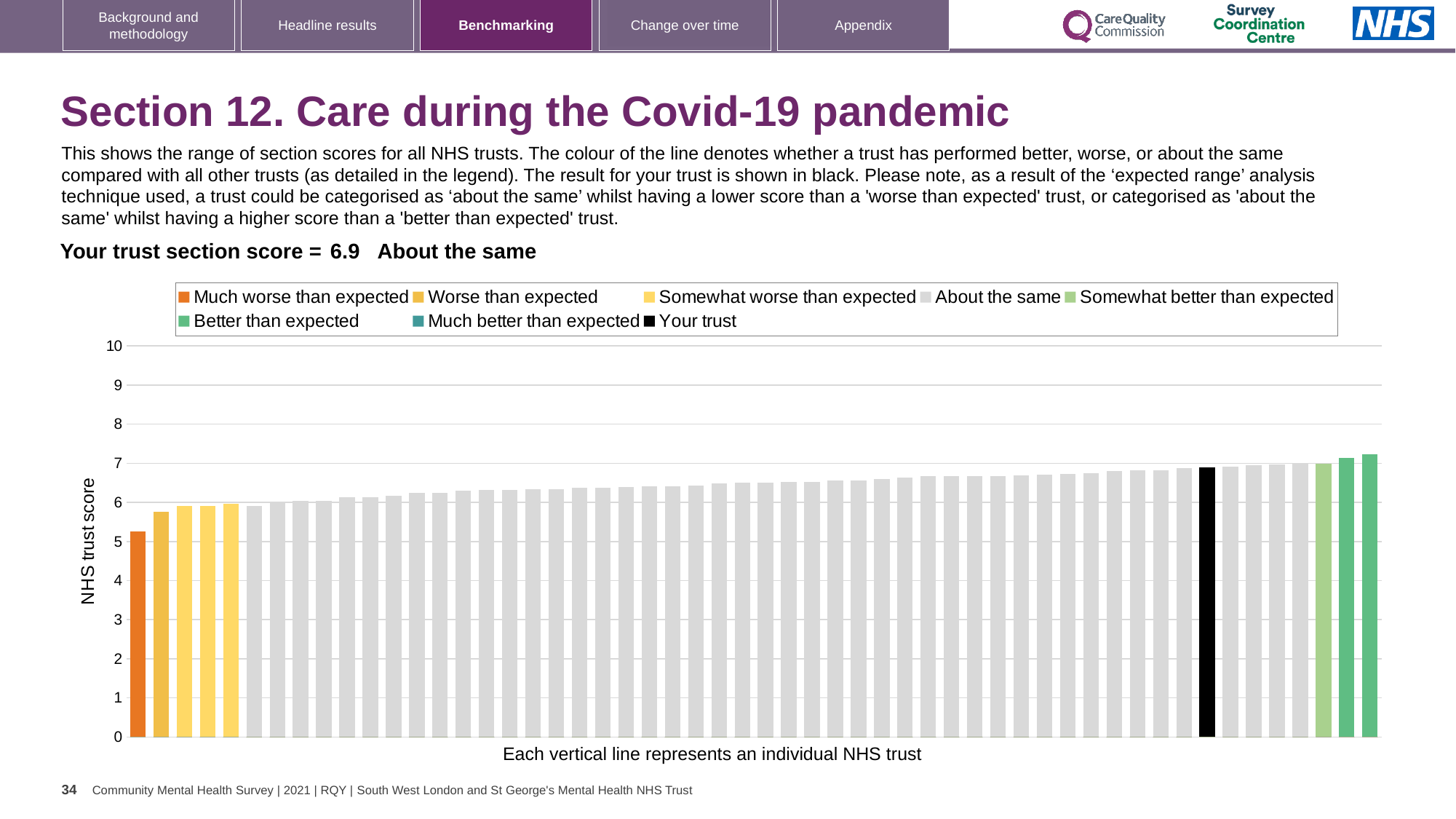
What is the label on the vertical axis of the chart? NHS trust score How many bars are coloured for 'Better than expected'? 2 What is the section score for your trust shown on the slide? 6.9 Which category is your trust placed in for this section? About the same Is the value of the tallest bar on the chart greater or less than 7? greater Do the bar values rise or fall from left to right along the x axis? rise How many entries does the chart legend list? 8 What kind of chart is shown on the slide? bar chart Is the value of the lowest bar (the orange 'Much worse than expected' bar) greater or less than 6? less What is the highest value shown on the vertical axis? 10 Is the value of the black 'Your trust' bar greater or less than 7? less How many bars are coloured orange for 'Much worse than expected'? 1